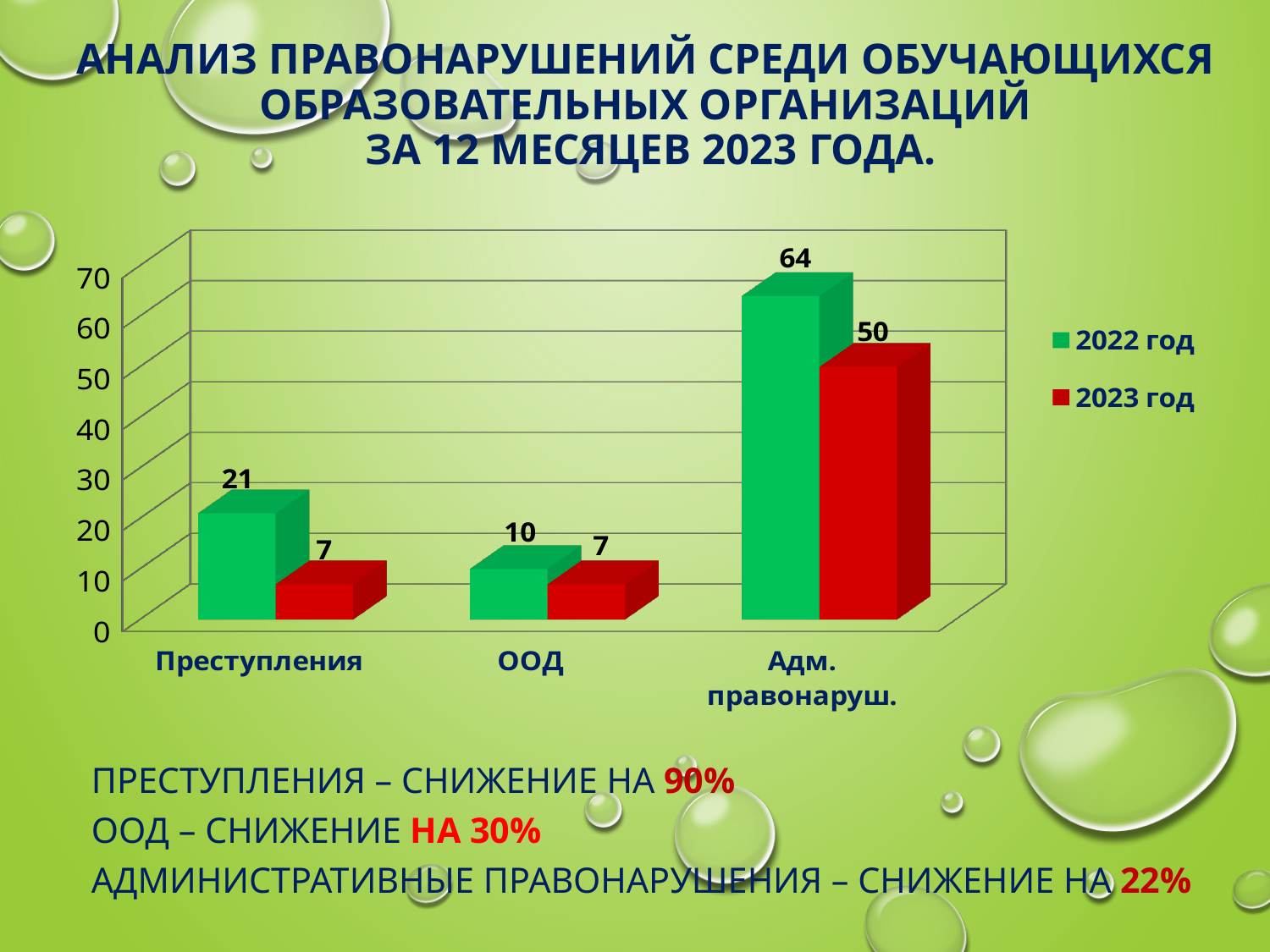
What is the difference between the 2022 год and 2023 год values for Адм. правонаруш.? 14 Which category has the highest value in the 2022 год series? Адм. правонаруш. How many series does the legend list? 2 How many categories are shown on the x axis? 3 What is the difference between the 2022 год and 2023 год values for Преступления? 14 What is the value for Преступления in the 2022 год series? 21 What kind of chart is shown on the slide? bar chart Is the 2022 год value for Адм. правонаруш. greater or less than 60? greater What is the value for ООД in the 2022 год series? 10 What is the value for Адм. правонаруш. in the 2023 год series? 50 Which category has the lowest value in the 2023 год series? Преступления and ООД (both 7) Which is larger for ООД: the 2022 год value or the 2023 год value? 2022 год